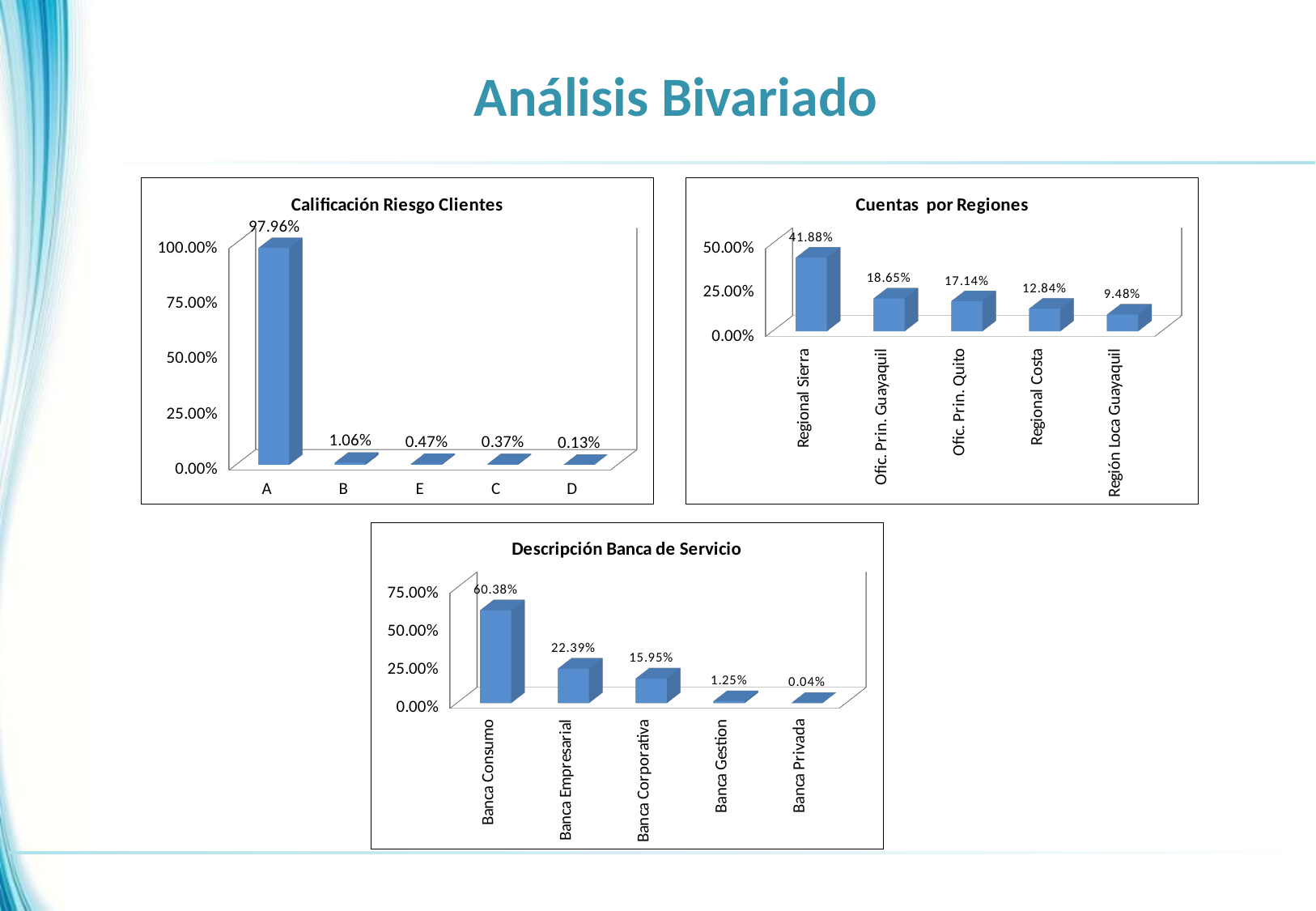
In the 'Cuentas por Regiones' chart, which is larger, Regional Costa or Región Loca Guayaquil? Regional Costa In the 'Calificación Riesgo Clientes' chart, which category has the lowest value? D In the 'Descripción Banca de Servicio' chart, which category has the lowest value? Banca Privada In the 'Cuentas por Regiones' chart, which region has the highest value? Regional Sierra In the 'Cuentas por Regiones' chart, what is the difference between Regional Sierra and Ofic. Prin. Guayaquil? 23.23% In the 'Descripción Banca de Servicio' chart, what is the difference between Banca Consumo and Banca Empresarial? 37.99% In the 'Calificación Riesgo Clientes' chart, what is the difference between the values for A and B? 96.90% In the 'Calificación Riesgo Clientes' chart, how many categories are shown on the x axis? 5 In the 'Calificación Riesgo Clientes' chart, what is the value for category A? 97.96% What kind of chart is the 'Descripción Banca de Servicio' chart? Bar chart In the 'Descripción Banca de Servicio' chart, what is the value for Banca Corporativa? 15.95% In the 'Cuentas por Regiones' chart, what is the value for Ofic. Prin. Quito? 17.14%